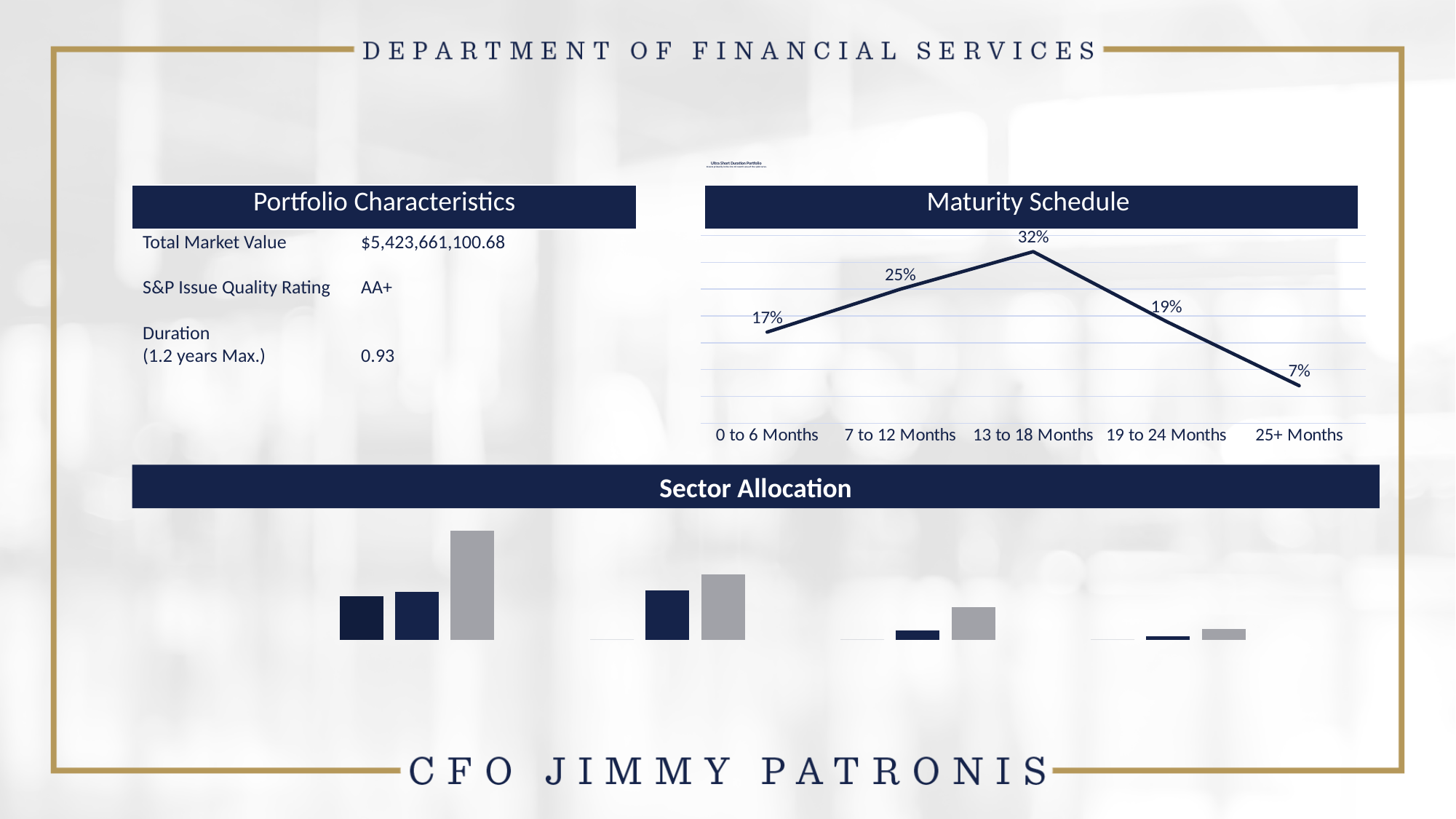
In the Maturity Schedule chart, what is the value for 25+ Months? 7% In the Maturity Schedule chart, what is the value for 0 to 6 Months? 17% In the Maturity Schedule chart, what is the difference between the values for 13 to 18 Months and 25+ Months? 25 percentage points How many maturity buckets are shown on the x axis of the Maturity Schedule chart? 5 In the Maturity Schedule chart, which is larger: the value for 7 to 12 Months or the value for 19 to 24 Months? 7 to 12 Months In the Maturity Schedule chart, what is the difference between the values for 7 to 12 Months and 0 to 6 Months? 8 percentage points In the Maturity Schedule chart, what is the value for 13 to 18 Months? 32% In the Maturity Schedule chart, do the values rise or fall from 13 to 18 Months to 25+ Months? Fall In the Maturity Schedule chart, which maturity bucket has the highest value? 13 to 18 Months What kind of chart is the Maturity Schedule chart? Line chart In the Maturity Schedule chart, which maturity bucket has the lowest value? 25+ Months In the Maturity Schedule chart, what is the value for 19 to 24 Months? 19%